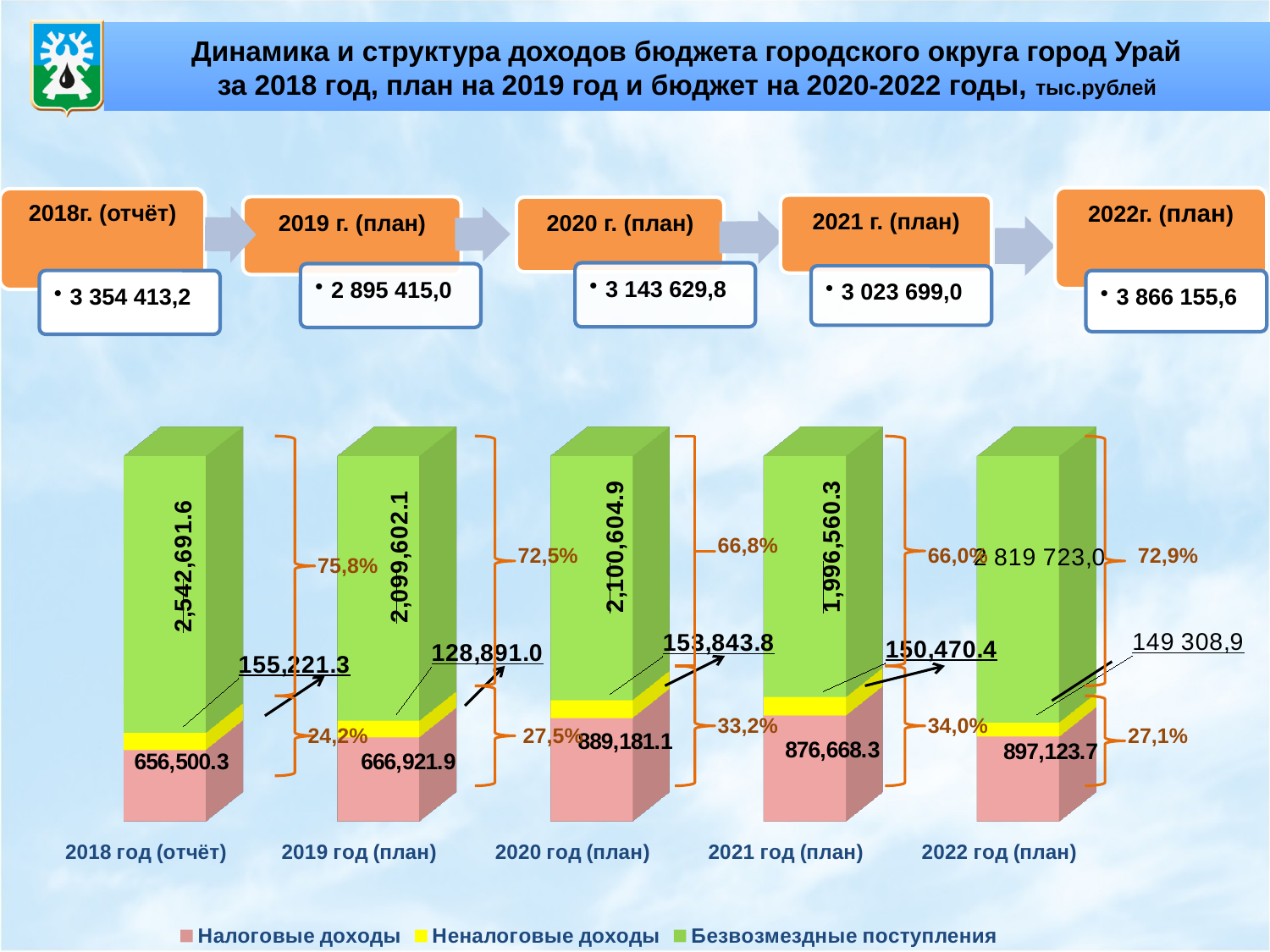
What is the value of Неналоговые доходы for 2021 год (план)? 150,470.4 What is the difference between Налоговые доходы in 2020 год (план) and 2019 год (план)? 222,259.2 What is the value of Налоговые доходы for 2020 год (план)? 889,181.1 How many years (categories) are shown on the x axis of the chart? 5 Which is larger: Неналоговые доходы in 2019 год (план) or in 2020 год (план)? 2020 год (план) In which year is the value of Безвозмездные поступления the highest? 2022 год (план) In which year is the value of Налоговые доходы the lowest? 2018 год (отчёт) What kind of chart is shown on the slide? Stacked bar chart What is the value of Безвозмездные поступления for 2018 год (отчёт)? 2,542,691.6 What is the value of Безвозмездные поступления for 2022 год (план)? 2 819 723,0 How many series does the chart legend list? 3 Which colour represents Неналоговые доходы in the chart? Yellow